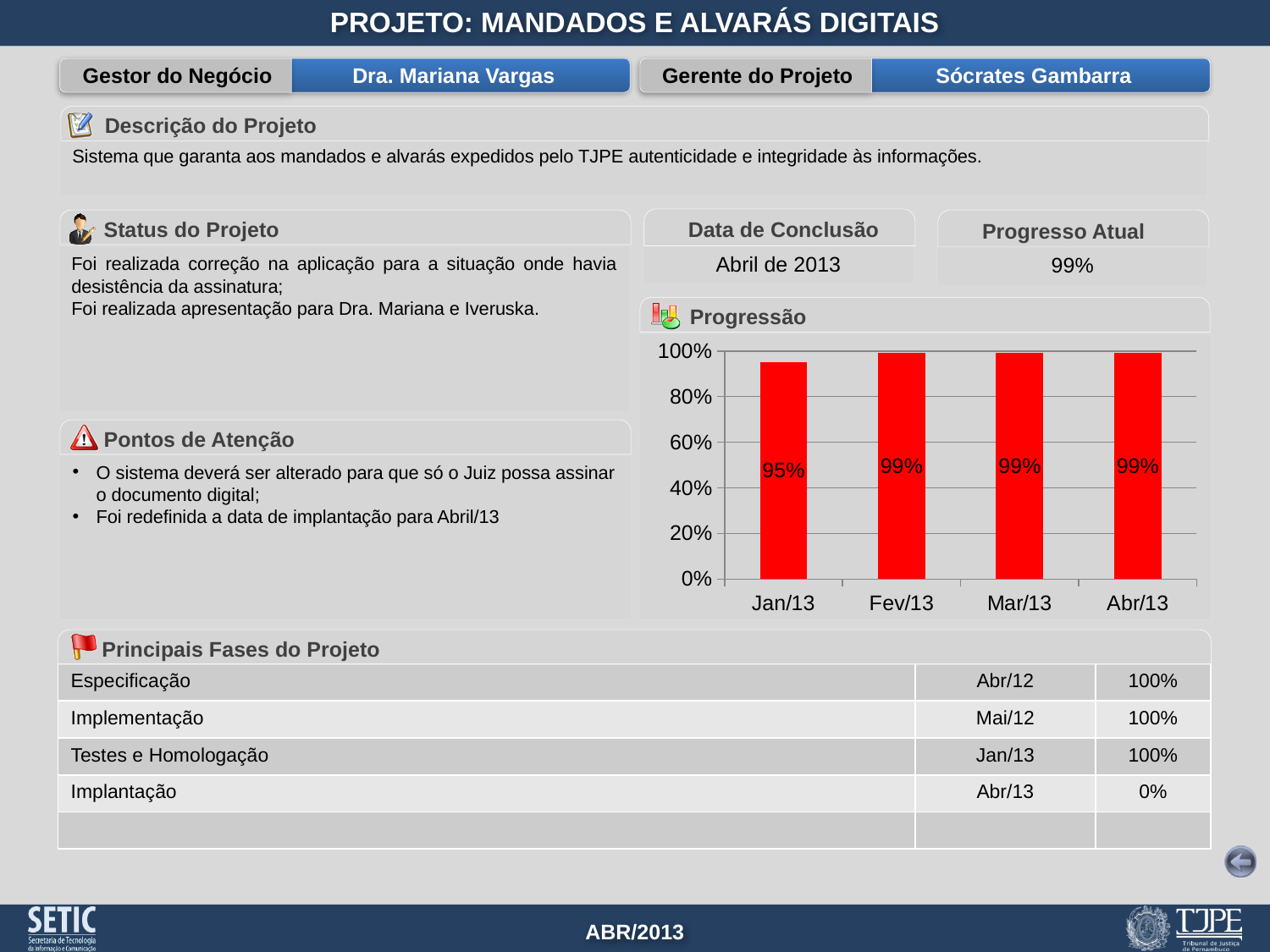
What kind of chart is the Progressão chart? bar chart What is the value for Jan/13 in the Progressão chart? 95% How many months are shown on the x axis of the Progressão chart? 4 What colour are the bars in the Progressão chart? red Which month has the lowest value in the Progressão chart? Jan/13 What is the title of the chart on the slide? Progressão What is the value for Fev/13 in the Progressão chart? 99% Is the value for Jan/13 in the Progressão chart greater or less than 80%? greater Which is larger in the Progressão chart, the value for Jan/13 or the value for Mar/13? Mar/13 Do the values in the Progressão chart rise or fall from Jan/13 to Fev/13? rise What is the difference between the values for Fev/13 and Jan/13 in the Progressão chart? 4% What is the value for Abr/13 in the Progressão chart? 99%